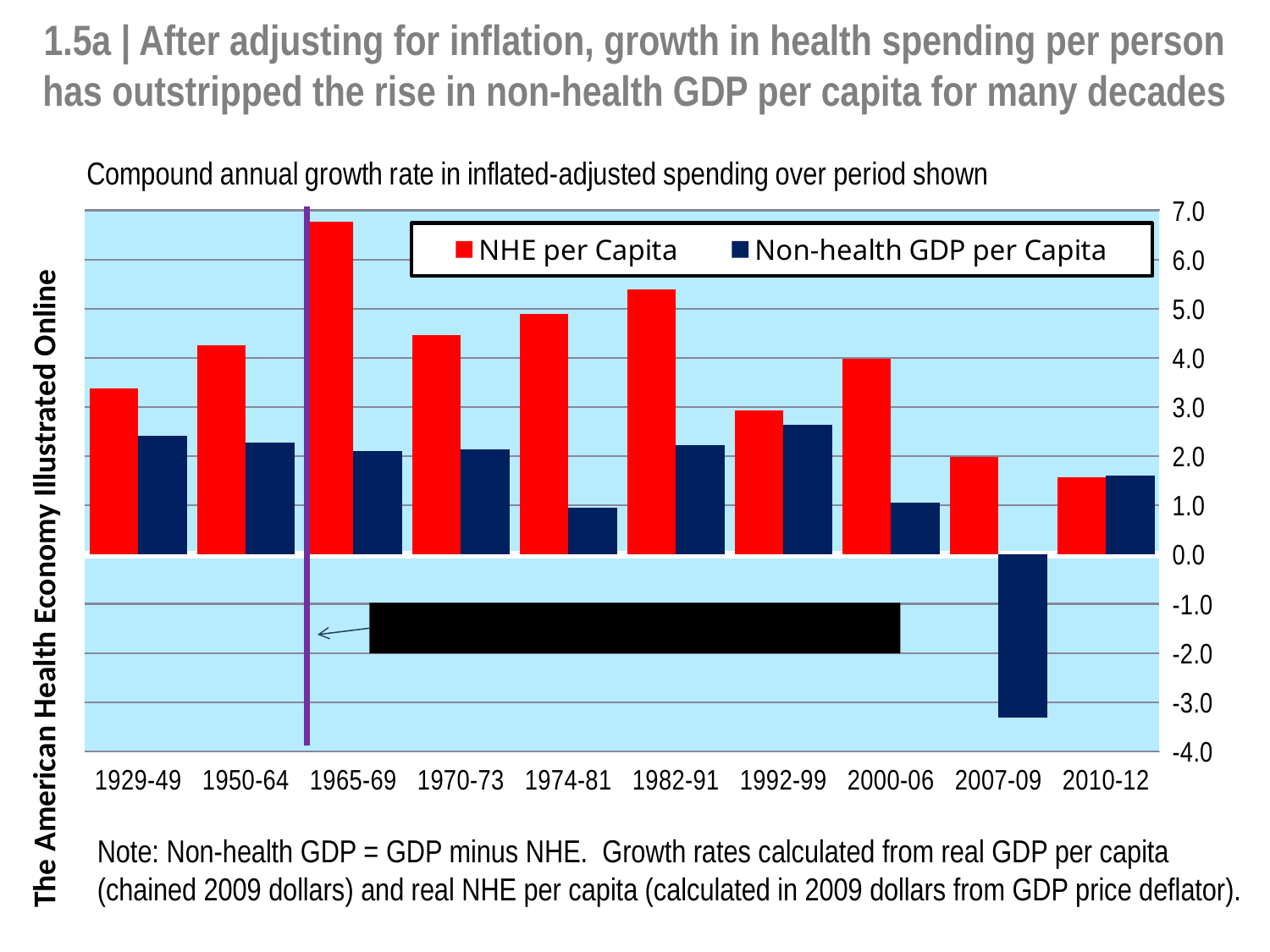
Which period has the highest NHE per Capita growth rate? 1965-69 Is the NHE per Capita value for 1982-91 greater or less than 5.0? greater How many time periods are shown on the x axis? 10 Which period has the lowest NHE per Capita growth rate? 2010-12 What kind of chart is shown on the slide? bar chart Is the NHE per Capita value for 1965-69 greater or less than 6.0? greater Which period has the lowest Non-health GDP per Capita growth rate? 2007-09 What colour are the NHE per Capita bars? red For 1929-49, which is larger: NHE per Capita or Non-health GDP per Capita? NHE per Capita How many series does the legend list? 2 Is the Non-health GDP per Capita value for 1974-81 greater or less than 2.0? less